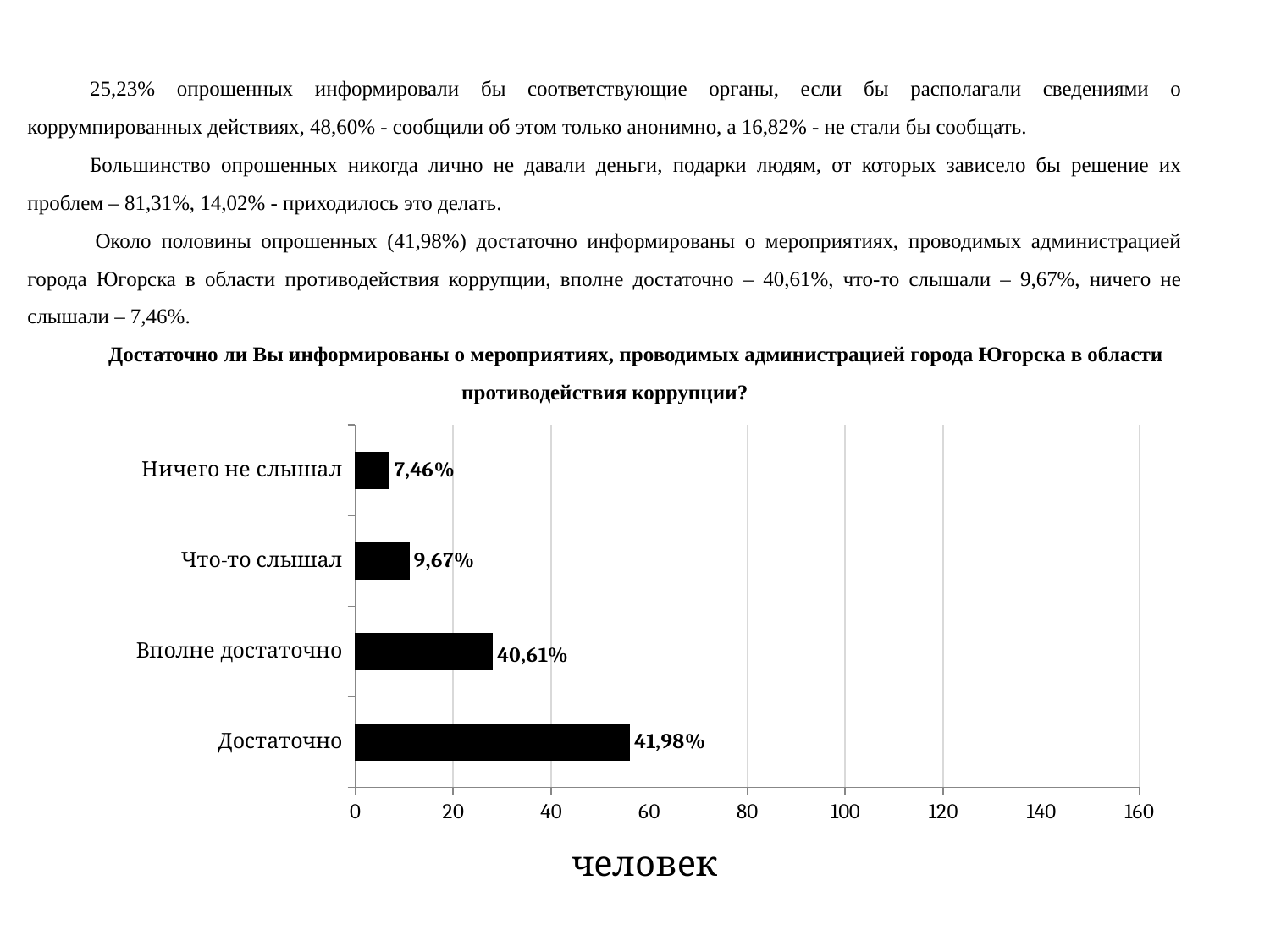
What data label is shown for the "Ничего не слышал" bar? 7,46% Which category has the longest bar? Достаточно Which category has the shortest bar? Ничего не слышал Is the bar for "Вполне достаточно" greater or less than 40 on the axis? less What data label is shown for the "Достаточно" bar? 41,98% Is the bar for "Достаточно" greater or less than 40 on the axis? greater How many categories are shown in the chart? 4 What data label is shown for the "Вполне достаточно" bar? 40,61% What is the difference between the data labels for "Достаточно" and "Вполне достаточно"? 1,37% What kind of chart is shown on the slide? Bar chart Which bar is longer: "Что-то слышал" or "Ничего не слышал"? Что-то слышал What data label is shown for the "Что-то слышал" bar? 9,67%